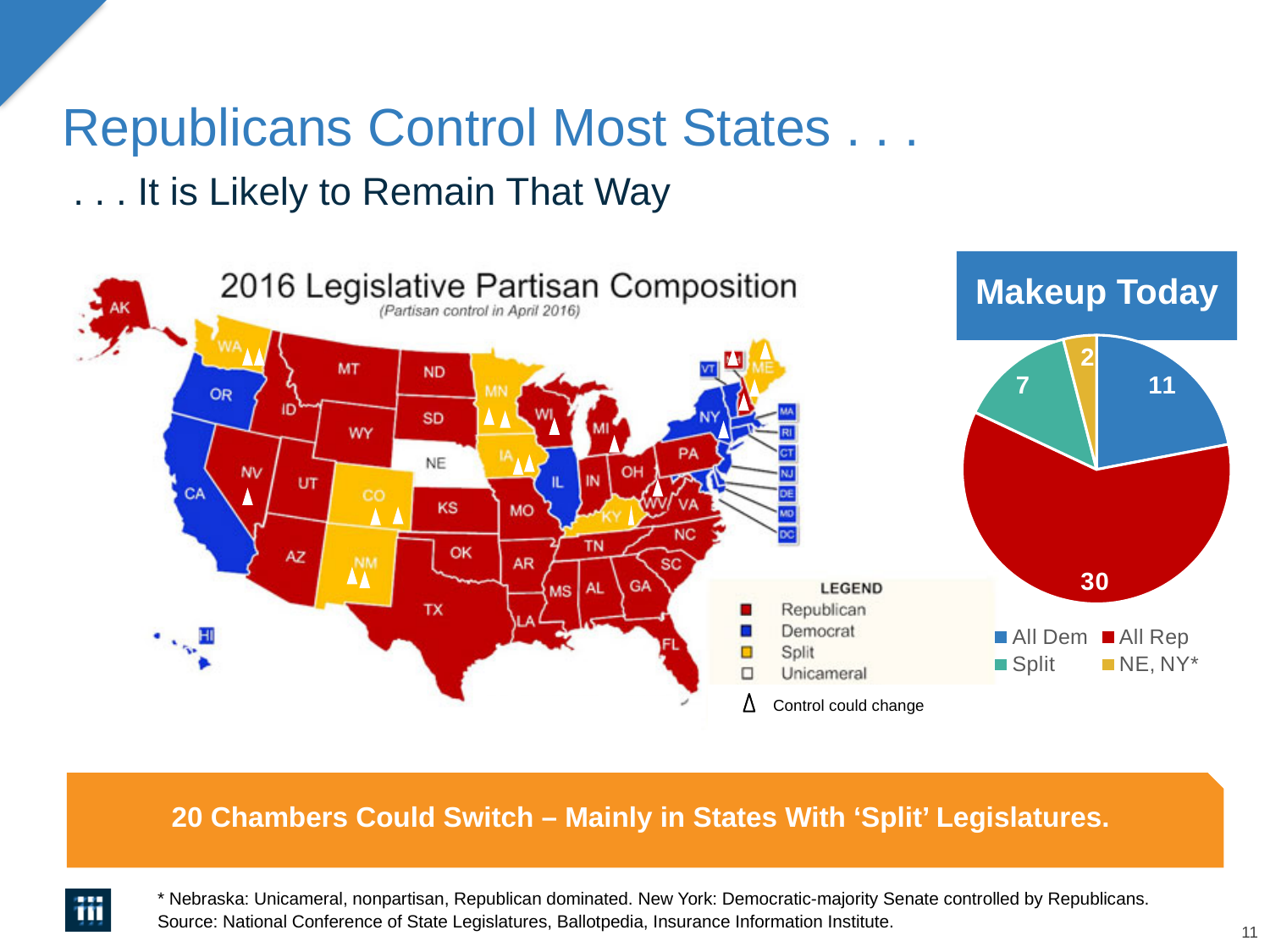
In the 'Makeup Today' pie chart, what is the value for NE, NY*? 2 In the 'Makeup Today' pie chart, which category has the smallest slice? NE, NY* In the 'Makeup Today' pie chart, what is the value for All Dem? 11 In the 'Makeup Today' pie chart, which is larger, All Dem or Split? All Dem What kind of chart is 'Makeup Today'? Pie chart In the 'Makeup Today' pie chart, what is the value for All Rep? 30 In the 'Makeup Today' pie chart, what colour is the All Rep slice? Red In the 'Makeup Today' pie chart, what is the value for Split? 7 In the 'Makeup Today' pie chart, what share of the total does the All Rep slice represent? 60% In the 'Makeup Today' pie chart, which category has the largest slice? All Rep How many slices does the 'Makeup Today' pie chart have? 4 In the 'Makeup Today' pie chart, what is the difference between the All Rep and All Dem values? 19